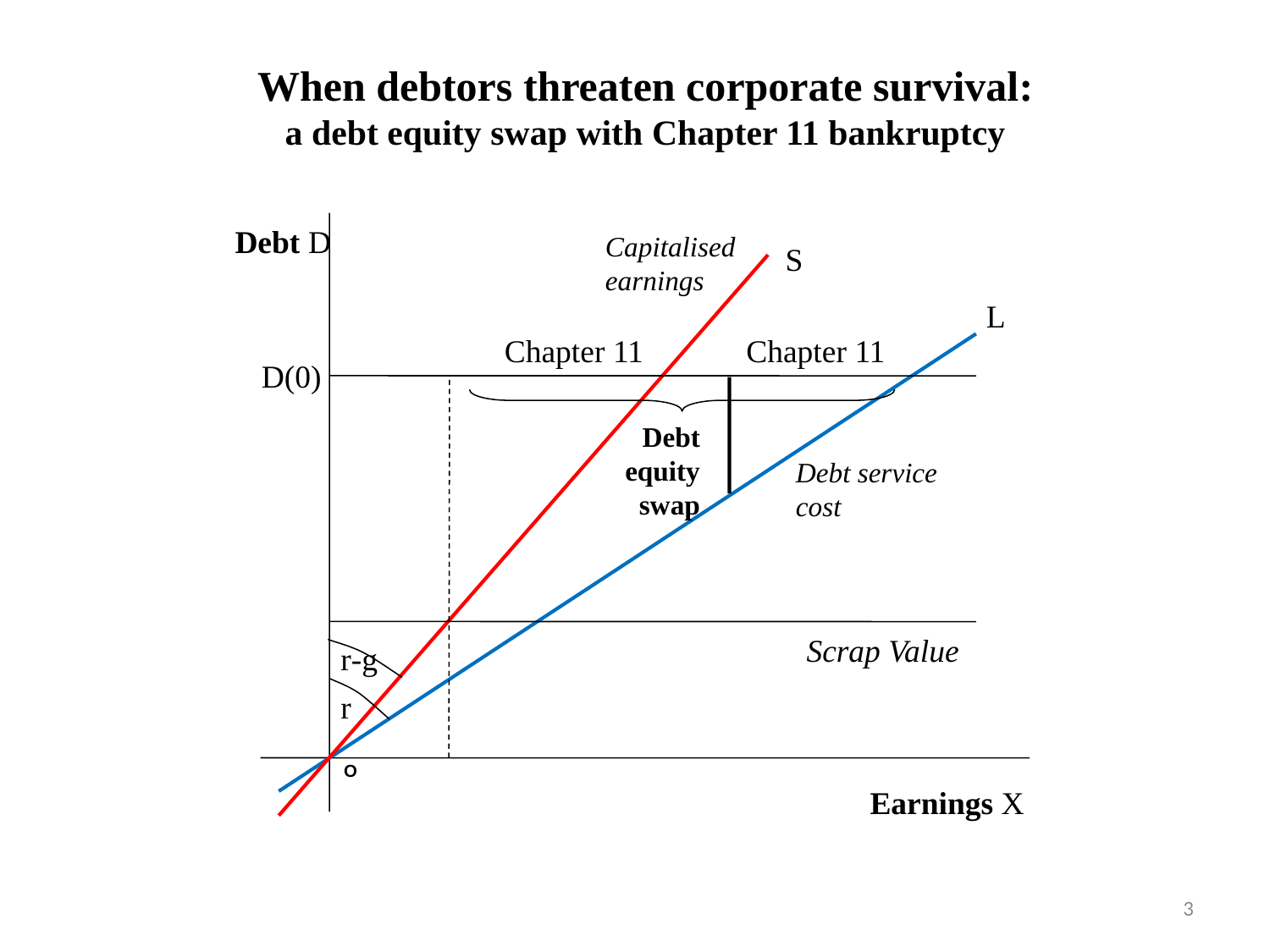
Which line has the steeper slope, the red line S or the blue line L? S What is the label on the horizontal axis of the diagram? Earnings X At high values of Earnings X, which line lies higher, S or L? S What is the label on the vertical axis of the diagram? Debt D Do the lines S and L rise or fall as Earnings X increase? rise Which line reaches the D(0) level first as Earnings X increase, S or L? S